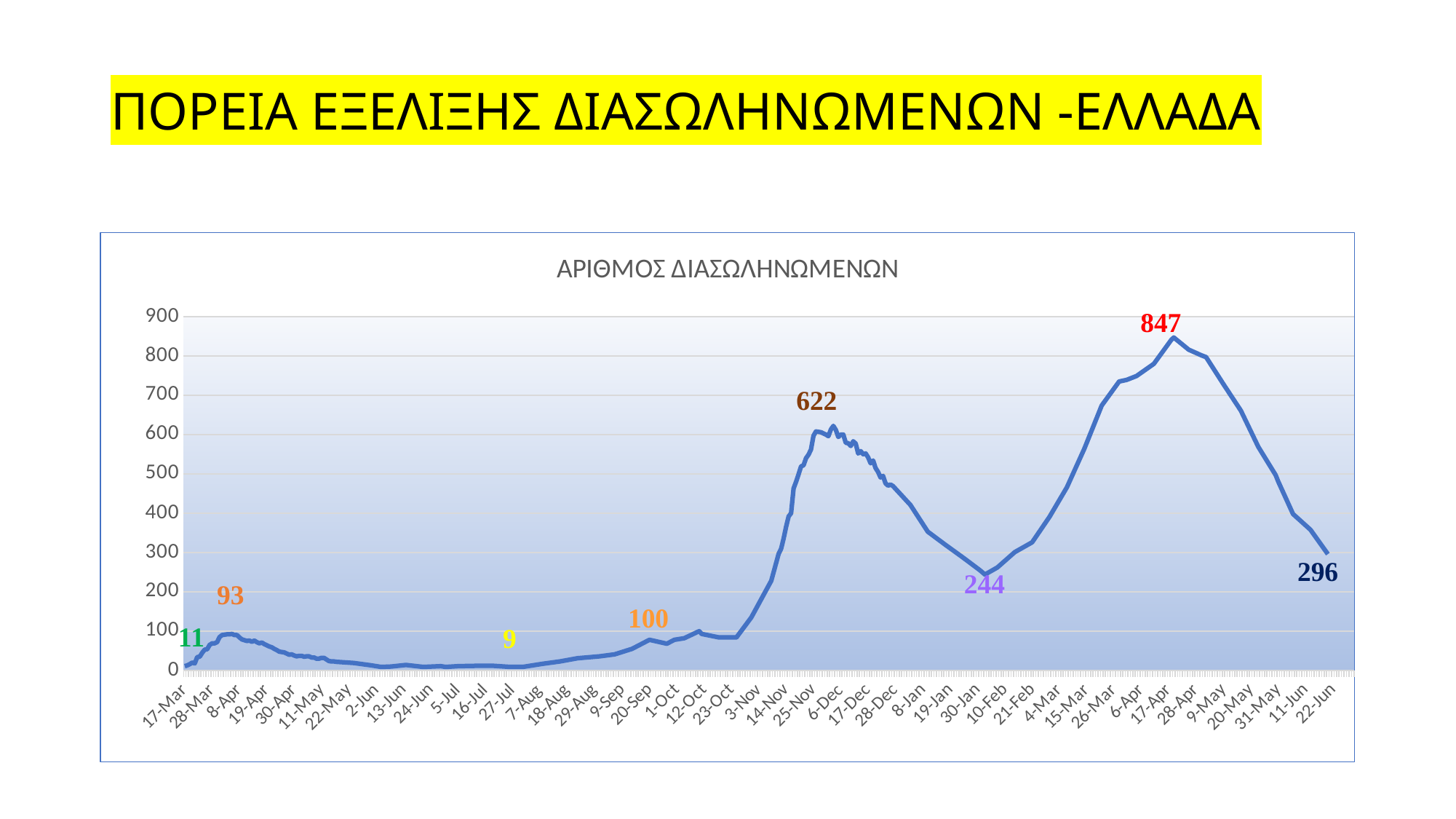
What value is labelled at the first point of the line (17-Mar)? 11 What kind of chart is shown on the slide? line chart What value is labelled at the trough around 30-Jan? 244 What is the highest value labelled on the chart? 847 What value is labelled at the last point of the line (22-Jun)? 296 What is the title of the chart? ΑΡΙΘΜΟΣ ΔΙΑΣΩΛΗΝΩΜΕΝΩΝ What is the lowest value labelled on the chart? 9 What is the difference between the labelled peak of 847 and the labelled peak of 622? 225 What value is labelled at the peak around 6-Dec? 622 Does the line rise or fall between 17-Apr and 22-Jun? fall Which labelled value is larger, the 93 near 8-Apr or the 100 near 20-Sep? 100